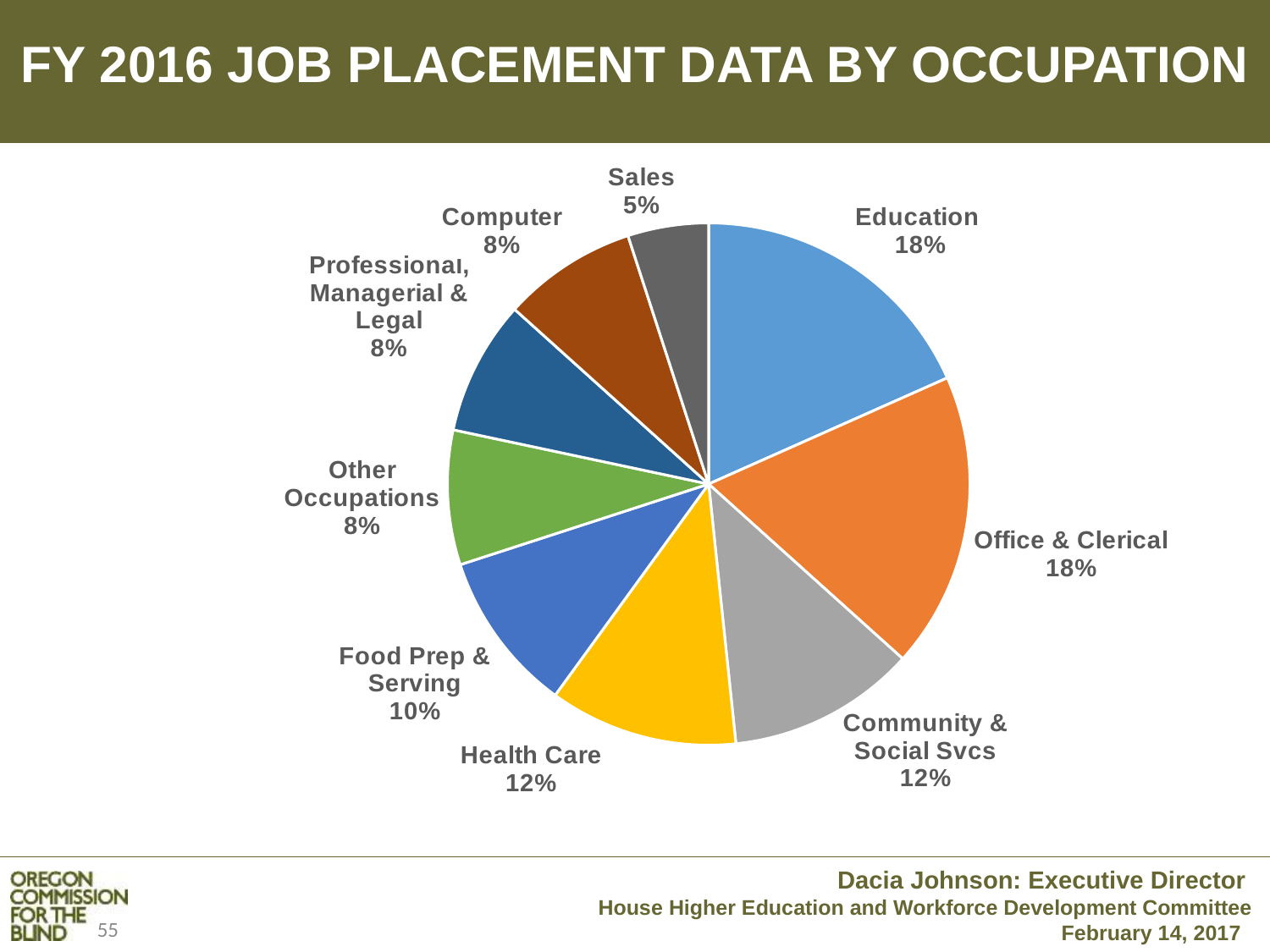
Which occupation has the smallest share of job placements? Sales What is the title of the slide containing the pie chart? FY 2016 Job Placement Data by Occupation What share of job placements is in Education? 18% What is the difference in percentage points between Education and Sales? 13 How many occupation categories are shown in the pie chart? 9 What percentage of job placements is in Food Prep & Serving? 10% What kind of chart is shown on the slide? Pie chart What share of the pie does Sales represent? 5% What is the difference in percentage points between Office & Clerical and Health Care? 6 What percentage is shown for Community & Social Svcs? 12% What is the combined share of Professional, Managerial & Legal and Other Occupations? 16% Which has a larger share, Food Prep & Serving or Computer? Food Prep & Serving